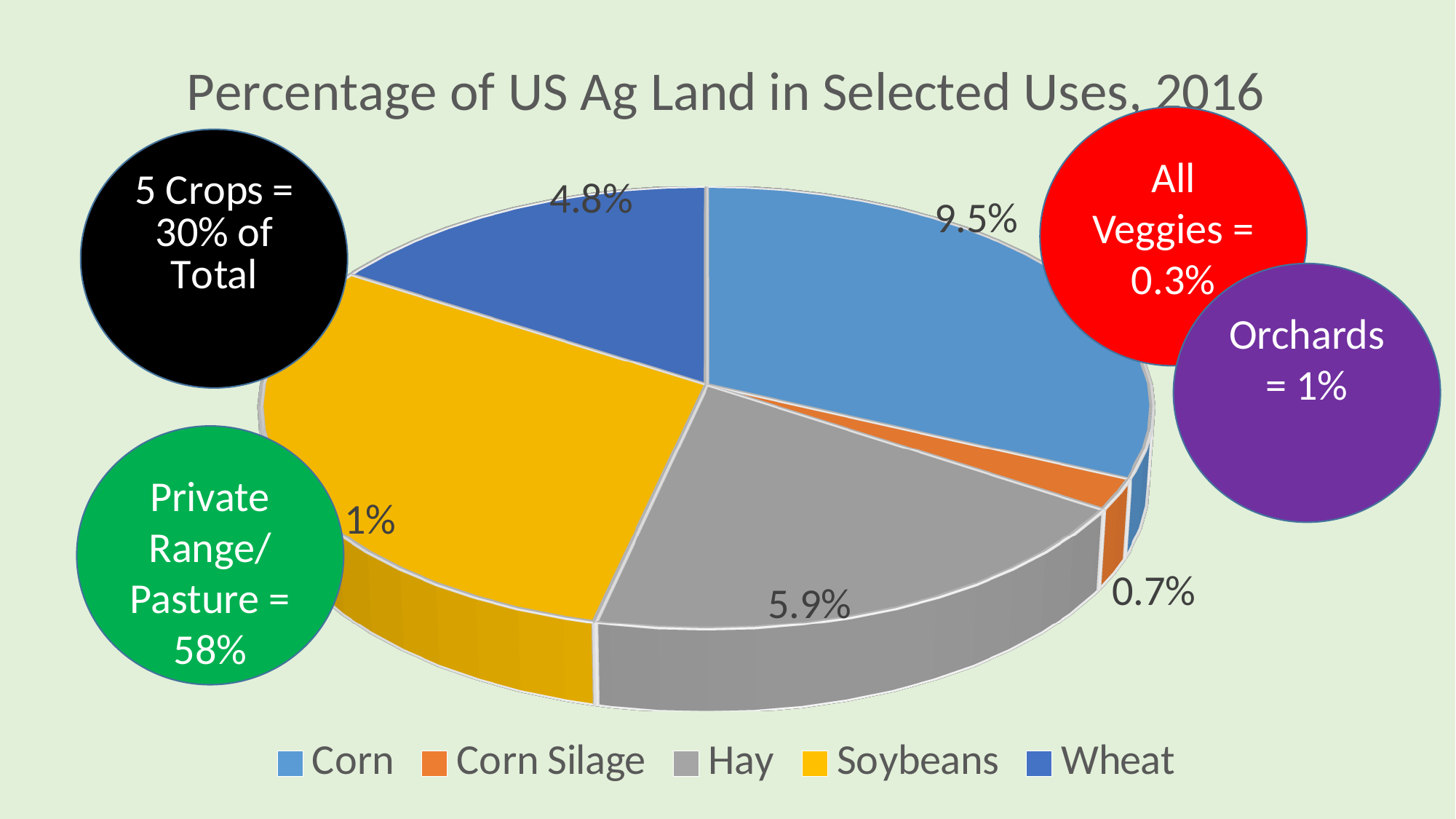
What is the title of the chart? Percentage of US Ag Land in Selected Uses, 2016 What type of chart is shown on the slide? pie chart What is the difference in percentage points between Corn and Hay? 3.6% Which has a larger share of US ag land, Hay or Wheat? Hay What percentage of US ag land is in Hay? 5.9% What is the difference in percentage points between Hay and Corn Silage? 5.2% What percentage of US ag land is in Corn Silage? 0.7% What percentage of US ag land is in Corn? 9.5% Which crop has the smallest share of US ag land in the pie chart? Corn Silage Which colour represents Hay in the pie chart? gray What percentage of US ag land is in Wheat? 4.8% How many crop categories are shown in the pie chart? 5